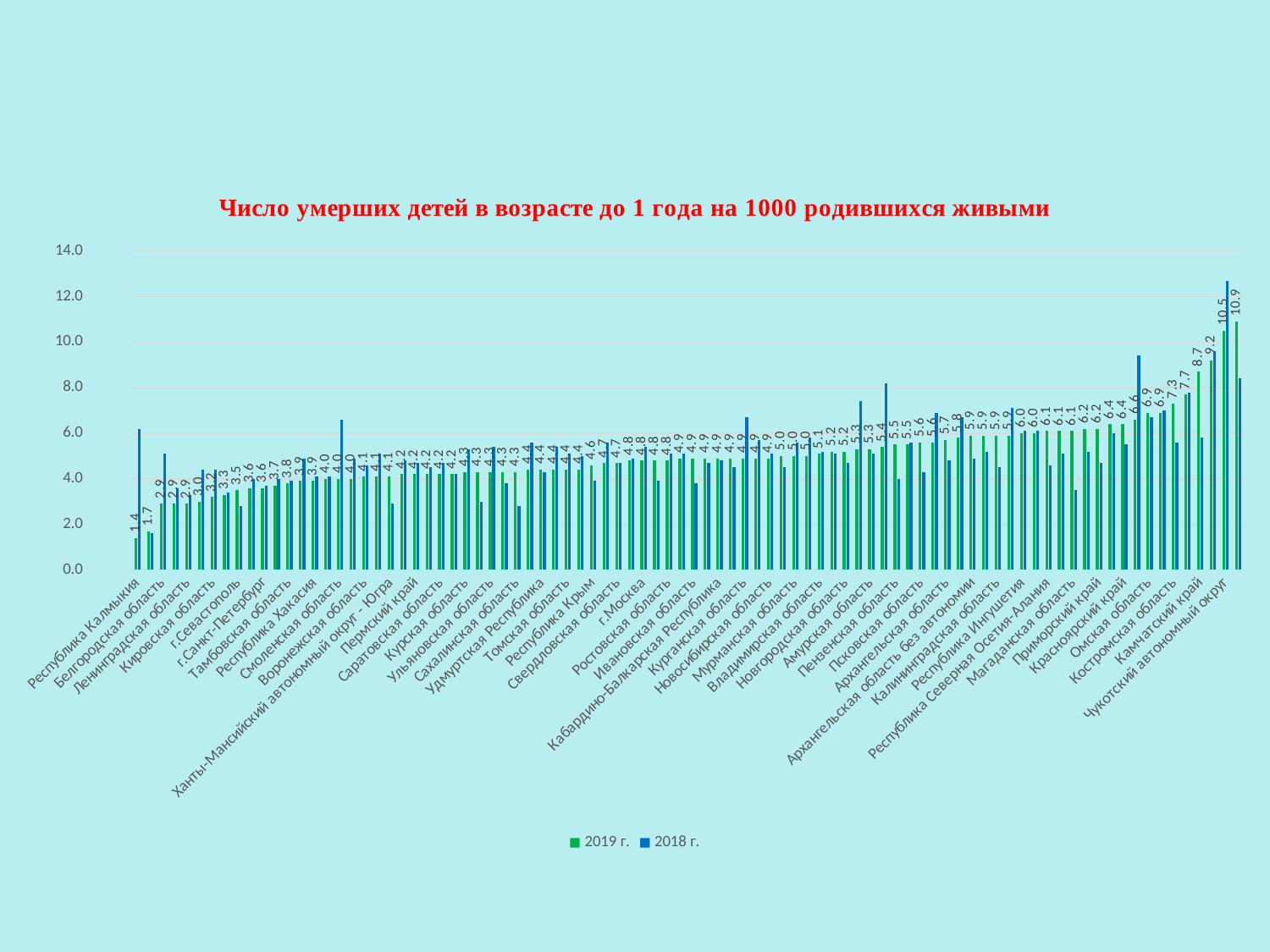
How many series does the legend list? 2 Is the 2018 г. value for Республика Калмыкия greater or less than 4.0? greater What is the 2019 г. value for Республика Калмыкия? 1.4 What are the two series named in the legend? 2019 г. and 2018 г. Which colour represents the 2019 г. series? green What kind of chart is shown on the slide? bar chart What is the 2019 г. value for Чукотский автономный округ? 10.5 Do the 2019 г. values generally rise or fall from left to right along the x axis? rise For Республика Калмыкия, which series has the larger value, 2019 г. or 2018 г.? 2018 г. Which region has the lowest 2019 г. value? Республика Калмыкия What is the difference between the 2019 г. values for Чукотский автономный округ and Республика Калмыкия? 9.1